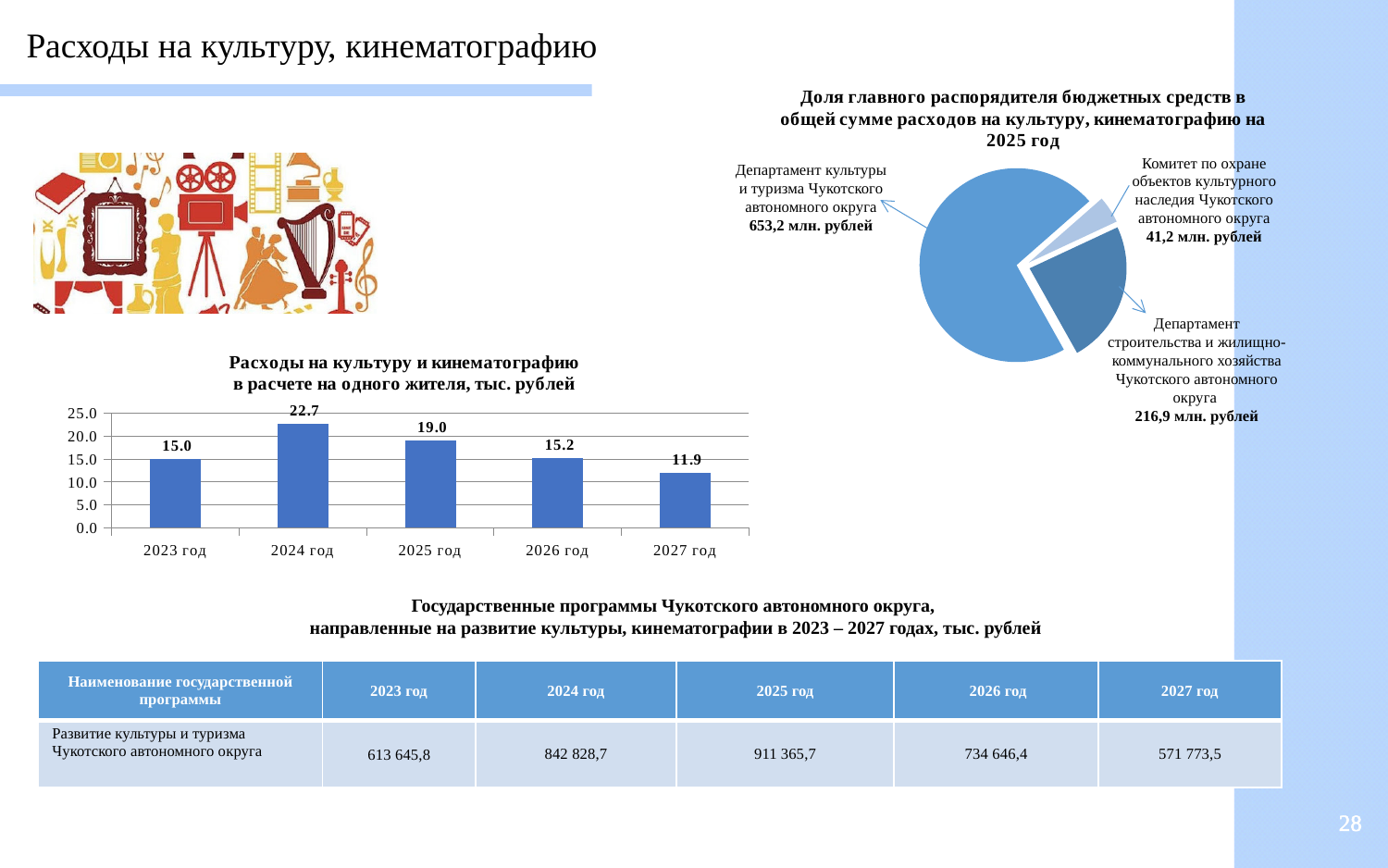
What kind of chart is 'Расходы на культуру и кинематографию в расчете на одного жителя, тыс. рублей'? bar chart In the pie chart 'Доля главного распорядителя бюджетных средств в общей сумме расходов на культуру, кинематографию на 2025 год', what is the value for Департамент культуры и туризма Чукотского автономного округа? 653,2 млн. рублей In the pie chart 'Доля главного распорядителя бюджетных средств в общей сумме расходов на культуру, кинематографию на 2025 год', how many slices are there? 3 In the bar chart 'Расходы на культуру и кинематографию в расчете на одного жителя, тыс. рублей', how many years are shown? 5 In the bar chart 'Расходы на культуру и кинематографию в расчете на одного жителя, тыс. рублей', which year has the lowest value? 2027 год In the bar chart 'Расходы на культуру и кинематографию в расчете на одного жителя, тыс. рублей', which is larger: the value for 2023 год or 2026 год? 2026 год In the bar chart 'Расходы на культуру и кинематографию в расчете на одного жителя, тыс. рублей', what is the difference between the values for 2024 год and 2025 год? 3.7 In the bar chart 'Расходы на культуру и кинематографию в расчете на одного жителя, тыс. рублей', which year has the highest value? 2024 год In the bar chart 'Расходы на культуру и кинематографию в расчете на одного жителя, тыс. рублей', what is the value for 2027 год? 11.9 In the bar chart 'Расходы на культуру и кинематографию в расчете на одного жителя, тыс. рублей', do the values rise or fall from 2024 год to 2027 год? fall In the pie chart 'Доля главного распорядителя бюджетных средств в общей сумме расходов на культуру, кинематографию на 2025 год', which slice is the smallest? Комитет по охране объектов культурного наследия Чукотского автономного округа In the bar chart 'Расходы на культуру и кинематографию в расчете на одного жителя, тыс. рублей', what is the value for 2024 год? 22.7